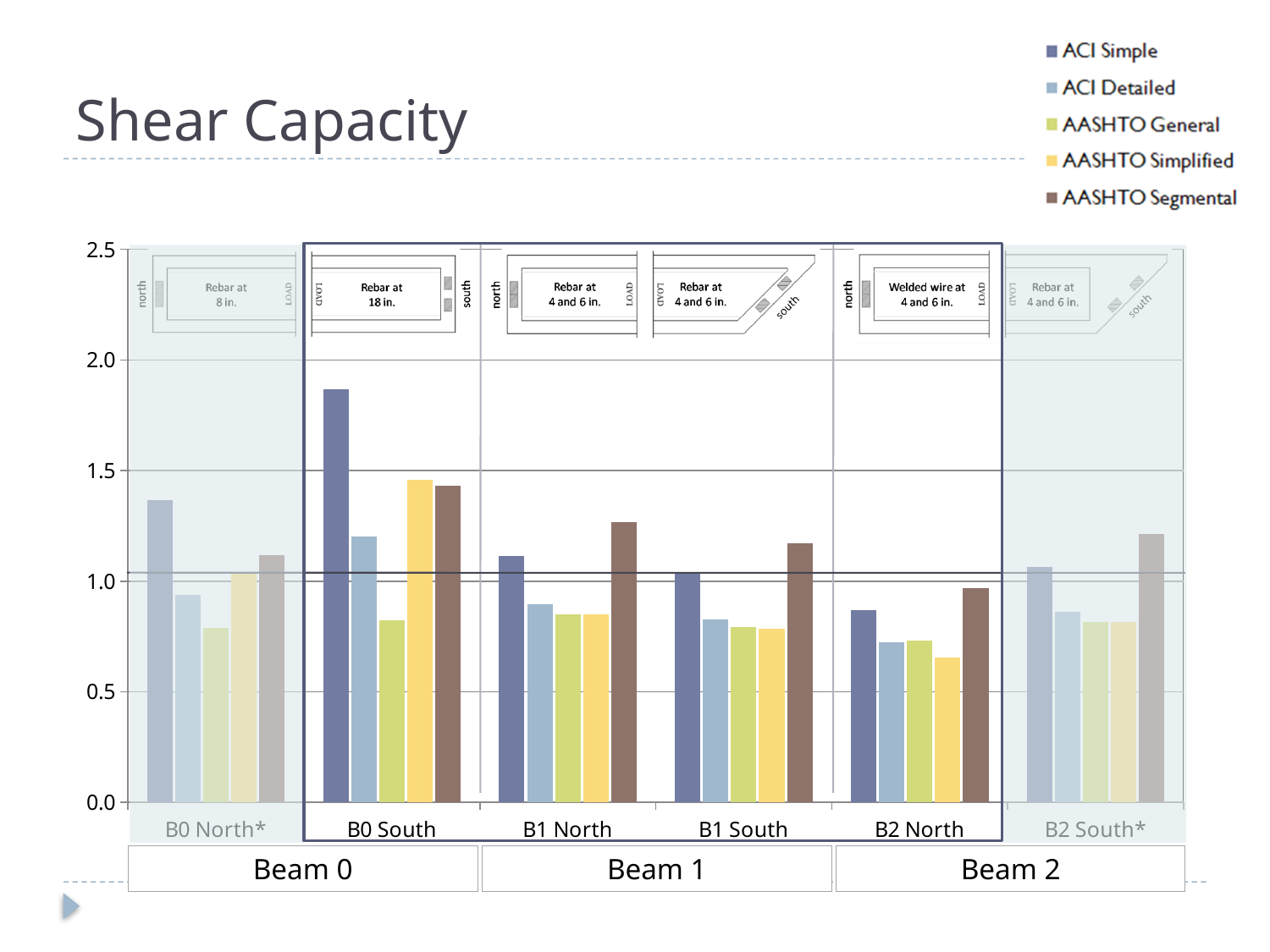
For B1 North, which is larger: the AASHTO Segmental value or the ACI Simple value? AASHTO Segmental Is the ACI Simple value for B0 South greater or less than 1.5? greater What kind of chart is shown on the slide? bar chart Which category has the lowest AASHTO Simplified value? B2 North How many beam-end categories are shown along the x axis? 6 Is the AASHTO Segmental value for B0 South greater or less than 1.0? greater What is the title of the slide containing the chart? Shear Capacity Is the AASHTO Simplified value for B2 North greater or less than 1.0? less For B0 South, which is larger: the ACI Simple value or the AASHTO General value? ACI Simple What colour represents AASHTO Simplified in the legend? yellow How many series does the legend list? 5 Which category has the highest ACI Simple value? B0 South